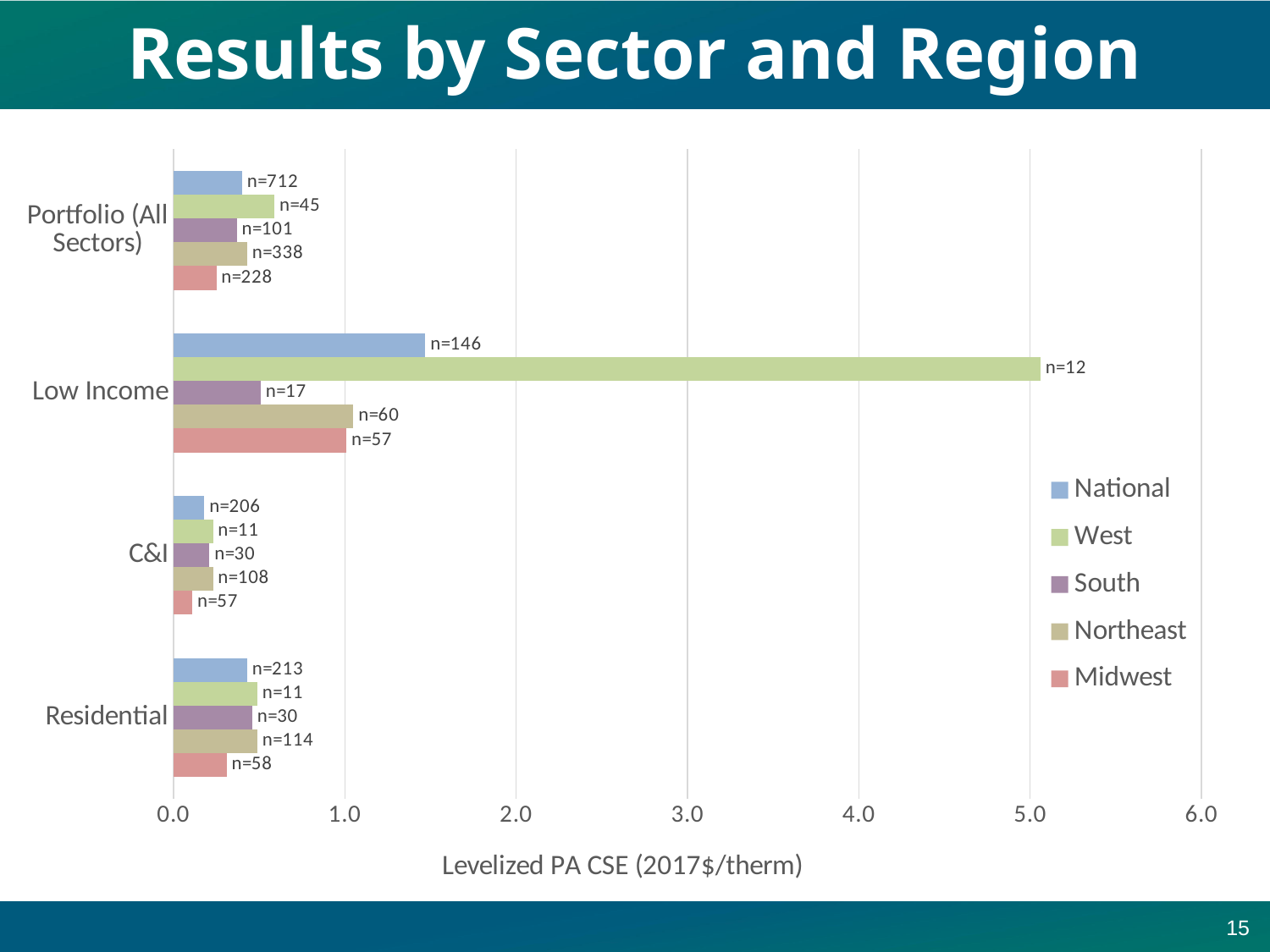
What is the x-axis title of the chart? Levelized PA CSE (2017$/therm) How many sector categories are shown on the chart? 4 Which region has the lowest Levelized PA CSE for C&I? Midwest Is the value for West in the Low Income category greater or less than 4.0? greater How many series does the legend list? 5 For Low Income, which is larger: the National value or the South value? National Which region has the highest Levelized PA CSE for Low Income? West Which region has the lowest Levelized PA CSE for Low Income? South What is the sample size label shown next to the West bar for Low Income? n=12 Is the value for National in the Low Income category greater or less than 1.0? greater Is the value for Midwest in the Portfolio (All Sectors) category greater or less than 1.0? less What type of chart is shown on the slide? bar chart